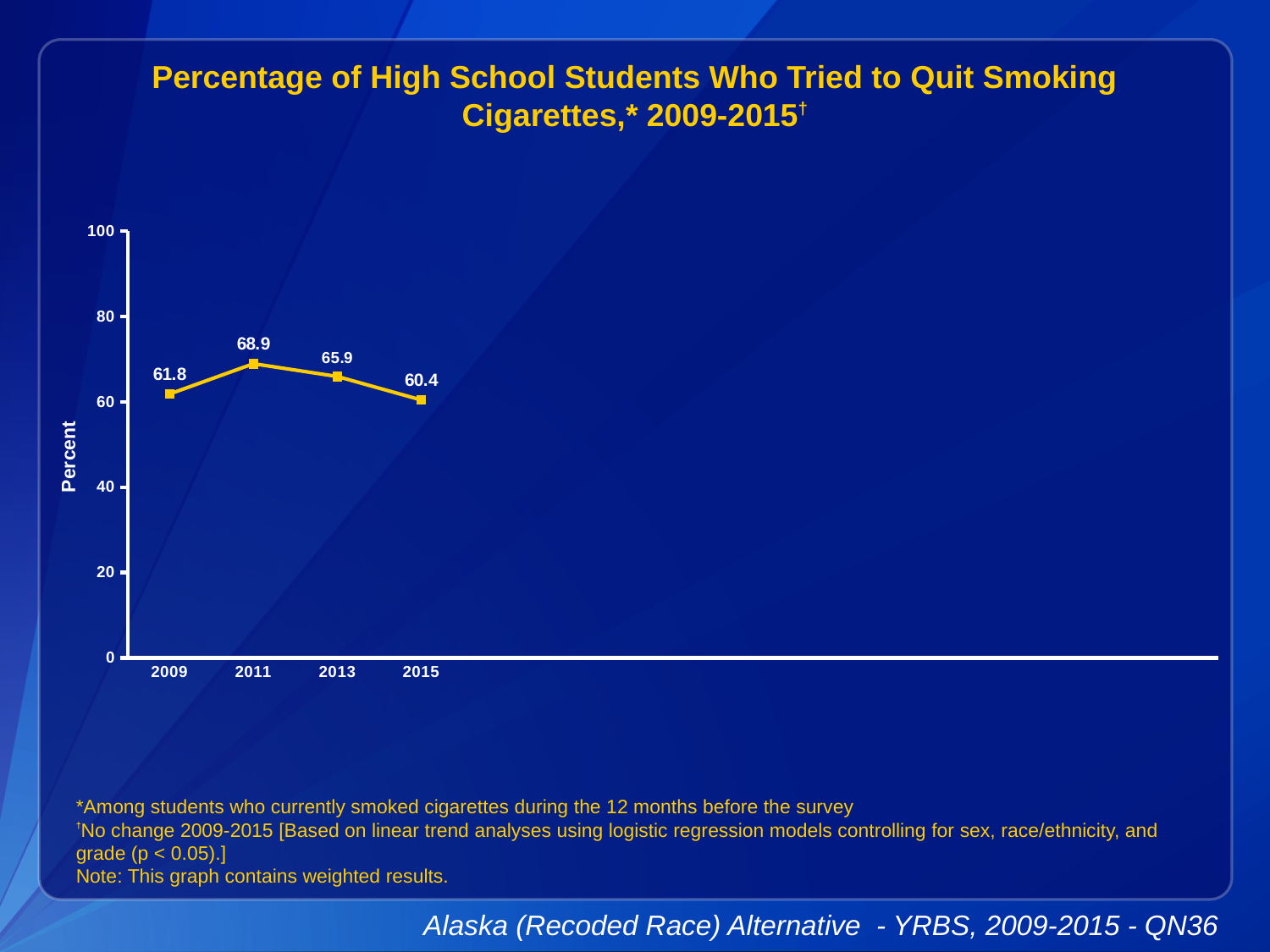
How many data points are plotted on the chart? 4 What is the value for 2009? 61.8 What kind of chart is shown on the slide? line chart Which year has the lowest value? 2015 What is the value for 2013? 65.9 What is the value for 2015? 60.4 What is the difference between the values for 2011 and 2015? 8.5 What is the value for 2011? 68.9 Which year has the highest value? 2011 Is the value for 2011 greater or less than 60? greater What is the label of the y axis? Percent Which is larger, the value for 2009 or the value for 2013? 2013